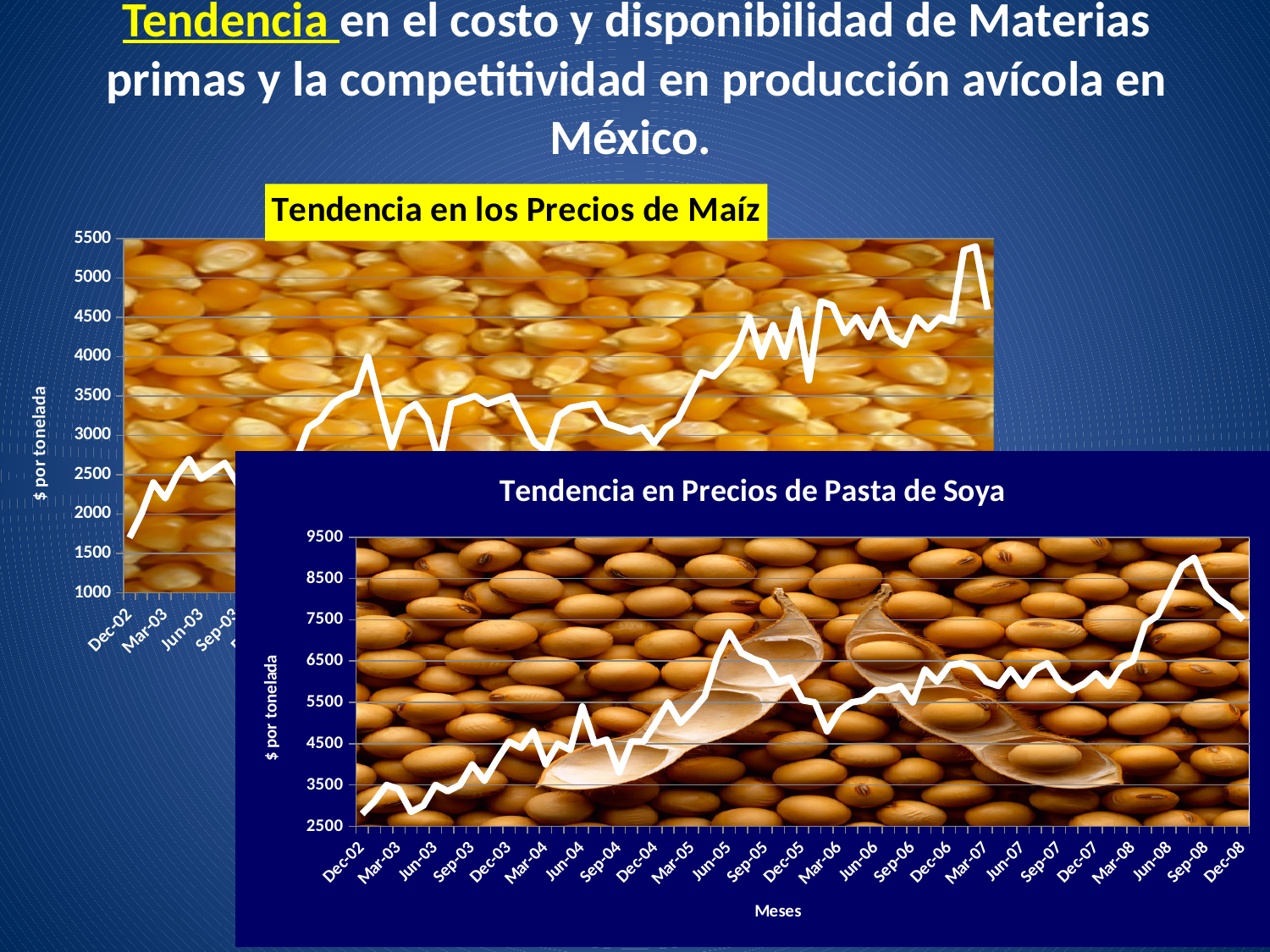
In the 'Tendencia en Precios de Pasta de Soya' chart, what is the label of the y axis? $ por tonelada How many x-axis labels are shown on the 'Tendencia en Precios de Pasta de Soya' chart? 25 In the 'Tendencia en Precios de Pasta de Soya' chart, is the value for Sep-08 greater or less than 7500? greater In the 'Tendencia en Precios de Pasta de Soya' chart, do the values overall rise or fall from Dec-02 to Dec-08? rise What kind of chart is 'Tendencia en los Precios de Maíz'? line chart In the 'Tendencia en Precios de Pasta de Soya' chart, is the value for Dec-08 greater or less than 8500? less In the 'Tendencia en los Precios de Maíz' chart, is the value for Dec-02 greater or less than 2000? less What kind of chart is 'Tendencia en Precios de Pasta de Soya'? line chart In the 'Tendencia en los Precios de Maíz' chart, do the values overall rise or fall from the start to the end of the series? rise In the 'Tendencia en Precios de Pasta de Soya' chart, what is the label of the x axis? Meses In the 'Tendencia en Precios de Pasta de Soya' chart, which is larger, the value for Sep-08 or the value for Dec-02? Sep-08